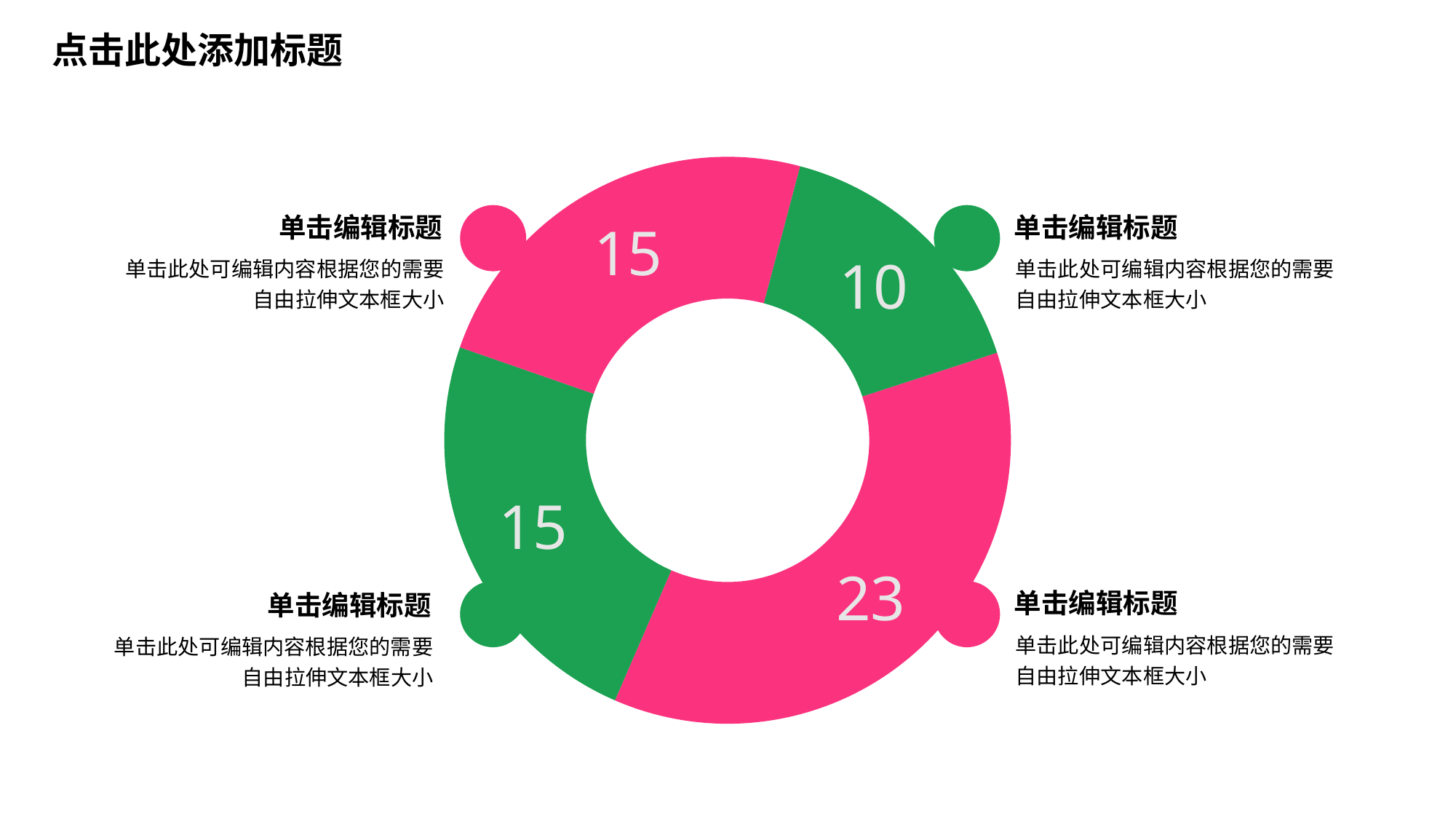
What value is shown on the green segment at the top right of the doughnut chart? 10 What is the sum of all four segment values on the doughnut chart? 63 Which is larger: the bottom-right pink segment or the top-right green segment? The bottom-right pink segment What kind of chart is shown on the slide? Doughnut chart What value is shown on the green segment at the bottom left of the doughnut chart? 15 What is the difference between the largest segment value (23) and the smallest segment value (10)? 13 How many different colours are used for the segments of the doughnut chart? 2 What is the smallest value shown on the doughnut chart? 10 What value is shown on the pink segment at the bottom right of the doughnut chart? 23 What value is shown on the pink segment at the top left of the doughnut chart? 15 What is the largest value shown on the doughnut chart? 23 How many segments does the doughnut chart have? 4